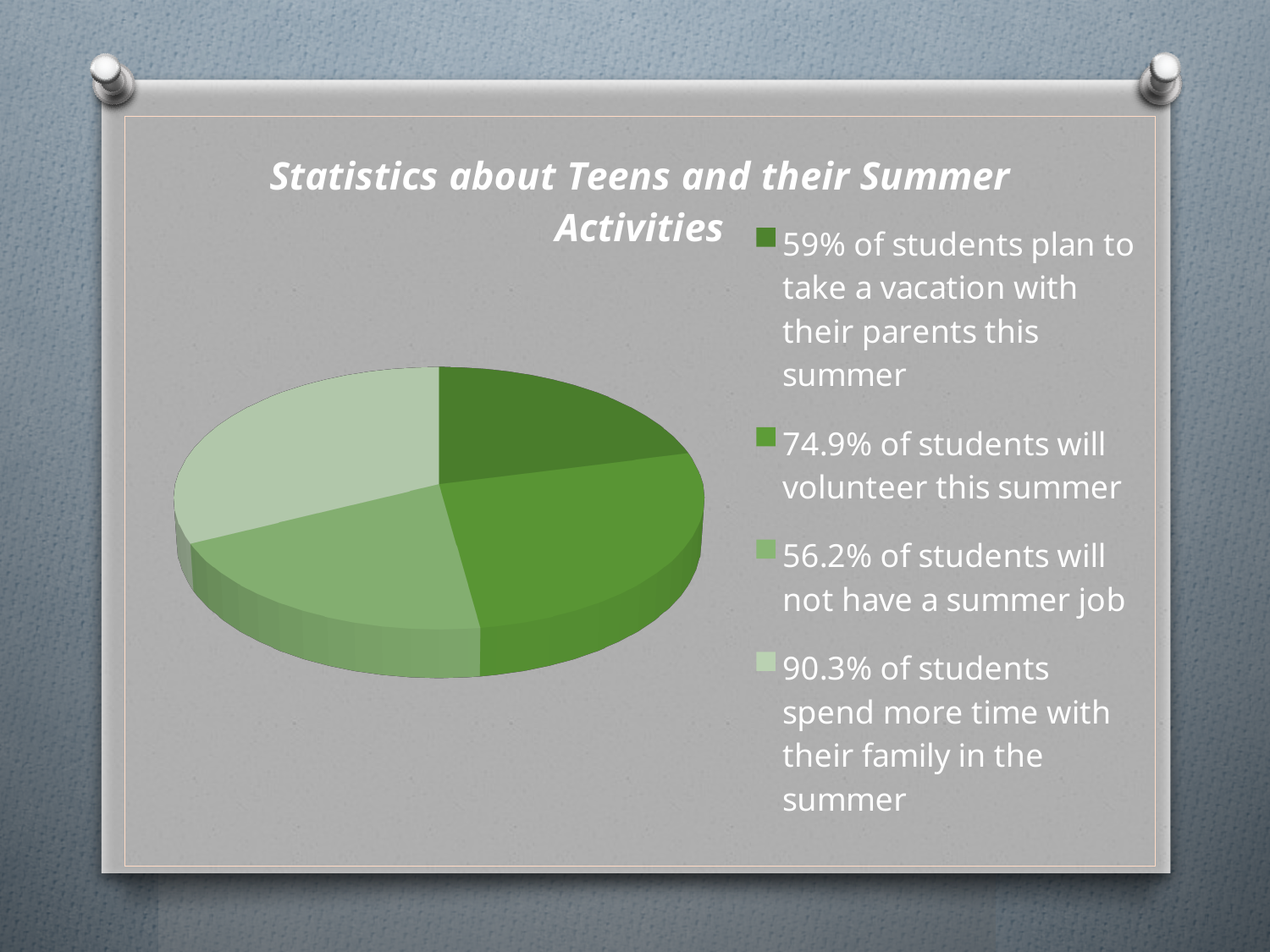
How many slices does the pie chart have? 4 According to the legend, what percentage of students plan to take a vacation with their parents this summer? 59% Which legend entry corresponds to the smallest slice of the pie? 56.2% of students will not have a summer job According to the legend, what percentage of students will volunteer this summer? 74.9% What is the title of the chart? Statistics about Teens and their Summer Activities According to the legend, what percentage of students spend more time with their family in the summer? 90.3% What kind of chart is shown on the slide? pie chart How many entries does the legend list? 4 Which legend entry corresponds to the largest slice of the pie? 90.3% of students spend more time with their family in the summer Which is larger: the percentage of students who will volunteer this summer or the percentage who plan to take a vacation with their parents? volunteer this summer According to the legend, what percentage of students will not have a summer job? 56.2% What is the difference between the percentage of students who spend more time with their family in the summer and the percentage who plan to take a vacation with their parents? 31.3 percentage points